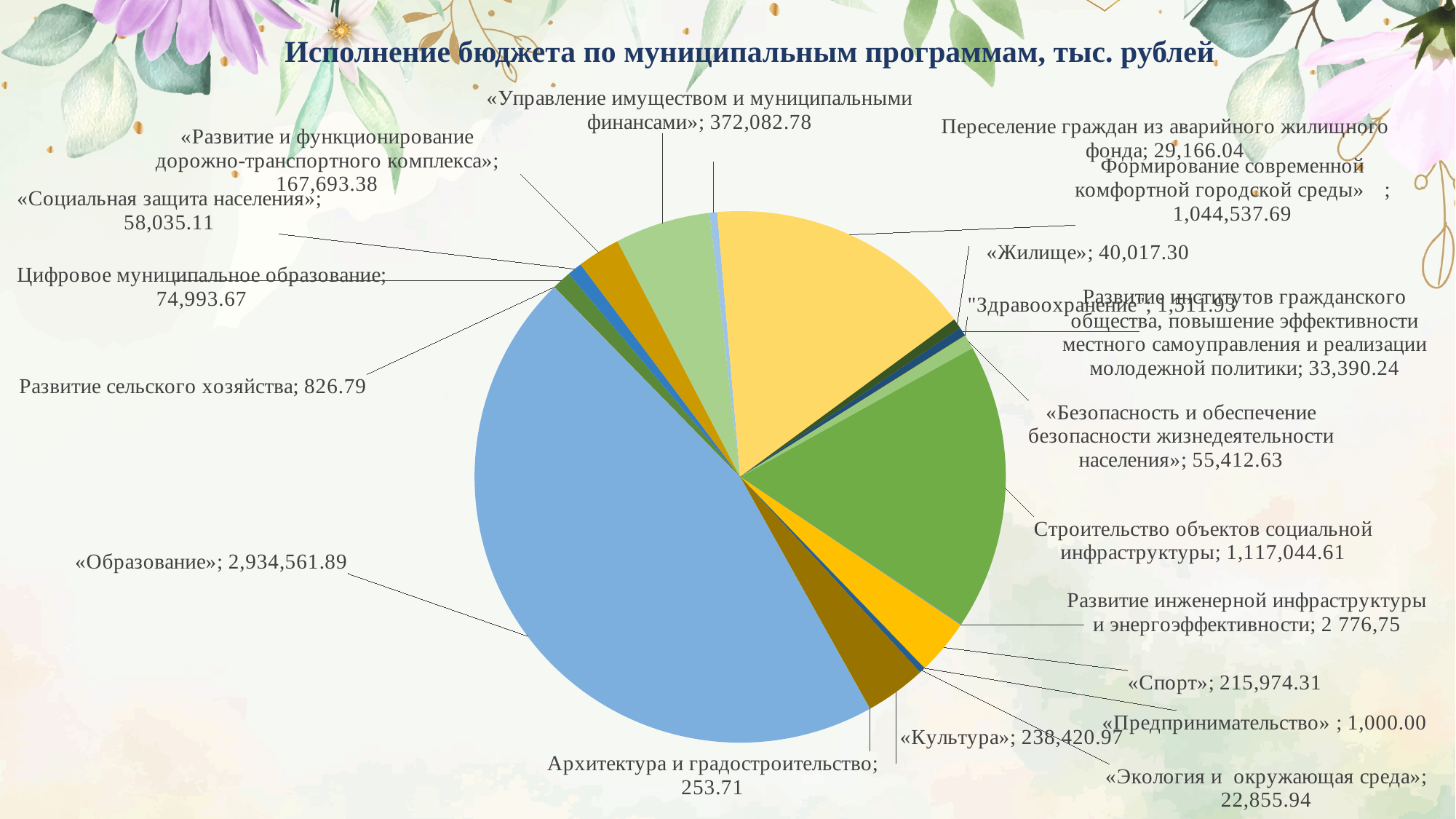
Which program has the largest slice of the pie? «Образование» Which program has the smallest value? Архитектура и градостроительство What is the value for «Спорт»? 215,974.31 How many programs (slices) are shown in the pie chart? 19 What is the value for Развитие сельского хозяйства? 826.79 What is the value for «Образование»? 2,934,561.89 What is the value for «Жилище»? 40,017.30 What is the value for Строительство объектов социальной инфраструктуры? 1,117,044.61 What kind of chart is shown on the slide? Pie chart What is the difference between Строительство объектов социальной инфраструктуры and Формирование современной комфортной городской среды? 72,506.92 Which is larger: «Управление имуществом и муниципальными финансами» or «Развитие и функционирование дорожно-транспортного комплекса»? «Управление имуществом и муниципальными финансами» What is the title of the chart? Исполнение бюджета по муниципальным программам, тыс. рублей